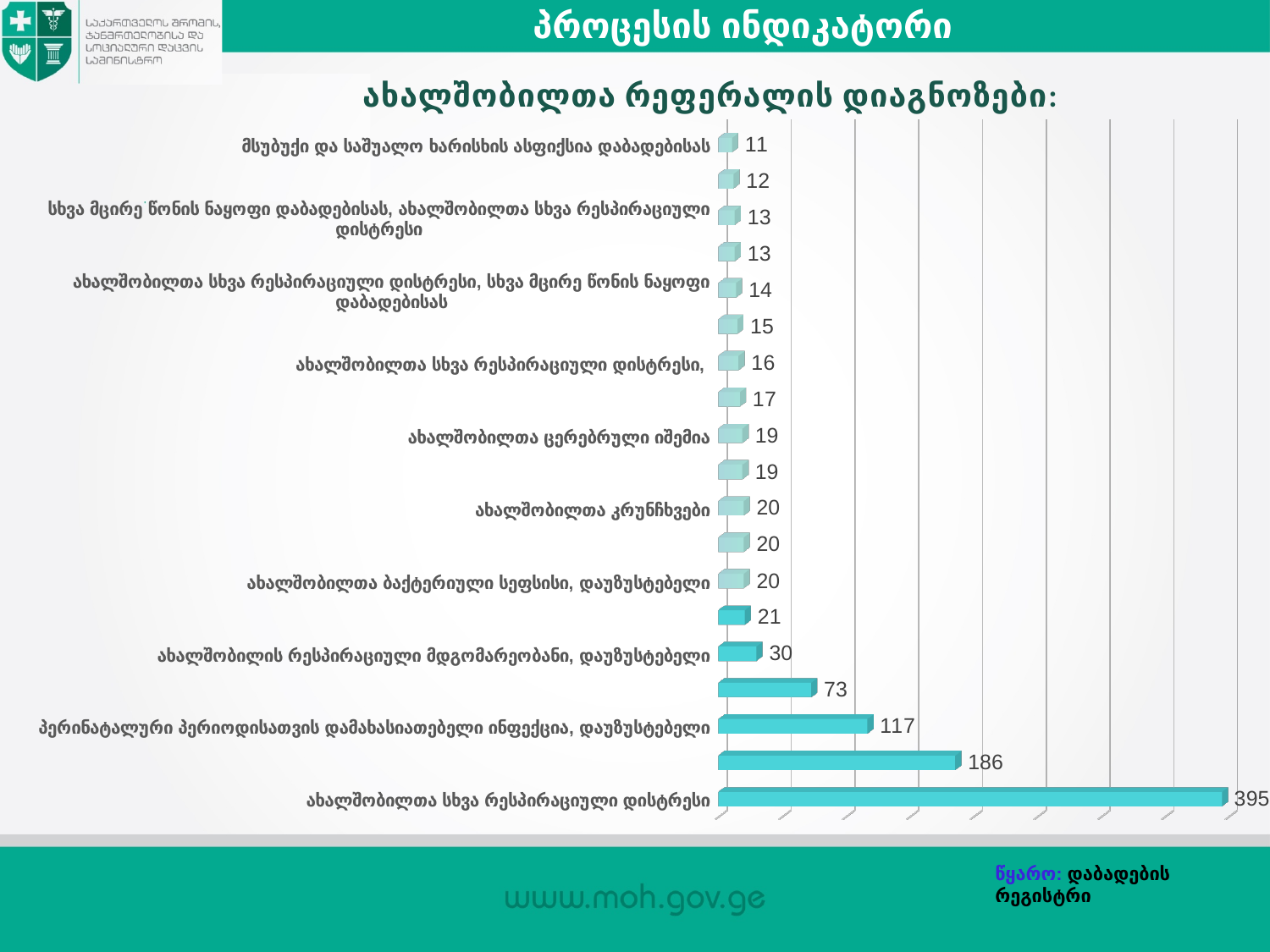
What is the highest value shown in the chart? 395 What is the value for ახალშობილთა კრუნჩხვები? 20 What is the value for ახალშობილთა ცერებრული იშემია? 19 Which category has the lowest value in the chart? მსუბუქი და საშუალო ხარისხის ასფიქსია დაბადებისას What is the difference between the largest bar (395) and the second largest bar (186)? 209 What is the value for პერინატალური პერიოდისათვის დამახასიათებელი ინფექცია, დაუზუსტებელი? 117 What is the value for მსუბუქი და საშუალო ხარისხის ასფიქსია დაბადებისას? 11 What is the title of the chart? ახალშობილთა რეფერალის დიაგნოზები: How many bars are plotted in the chart? 19 What kind of chart is shown on the slide? bar chart Which is larger: the value for ახალშობილთა ბაქტერიული სეფსისი, დაუზუსტებელი or the value for ახალშობილის რესპირაციული მდგომარეობანი, დაუზუსტებელი? ახალშობილის რესპირაციული მდგომარეობანი, დაუზუსტებელი What is the value for ახალშობილის რესპირაციული მდგომარეობანი, დაუზუსტებელი? 30